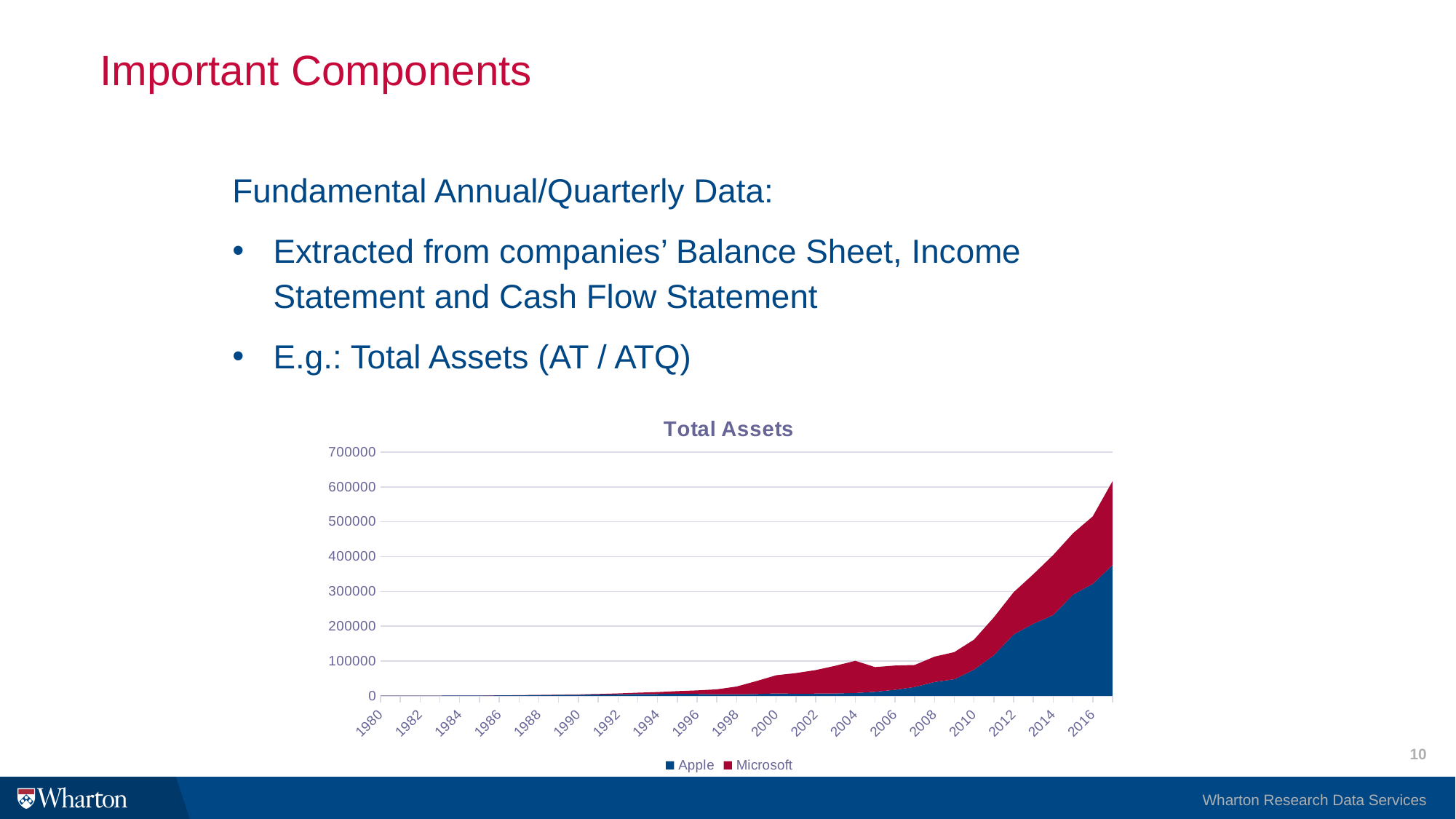
Which two companies are listed in the legend of the Total Assets chart? Apple and Microsoft How many year labels are shown on the x axis of the Total Assets chart? 19 What kind of chart is shown under the title "Total Assets"? area chart In the Total Assets chart, is the value for Apple in 2010 greater or less than 100000? less In the Total Assets chart, which company has the larger total assets in 2000, Apple or Microsoft? Microsoft How many series does the legend of the Total Assets chart list? 2 In the Total Assets chart, is the combined total of Apple and Microsoft in 2000 greater or less than 100000? less In the Total Assets chart, is the combined total of Apple and Microsoft in 2014 greater or less than 300000? greater In the Total Assets chart, which company has the larger total assets in 2016, Apple or Microsoft? Apple What is the title of the chart on the slide? Total Assets Do the total assets in the chart generally rise or fall from 1980 to 2016? rise